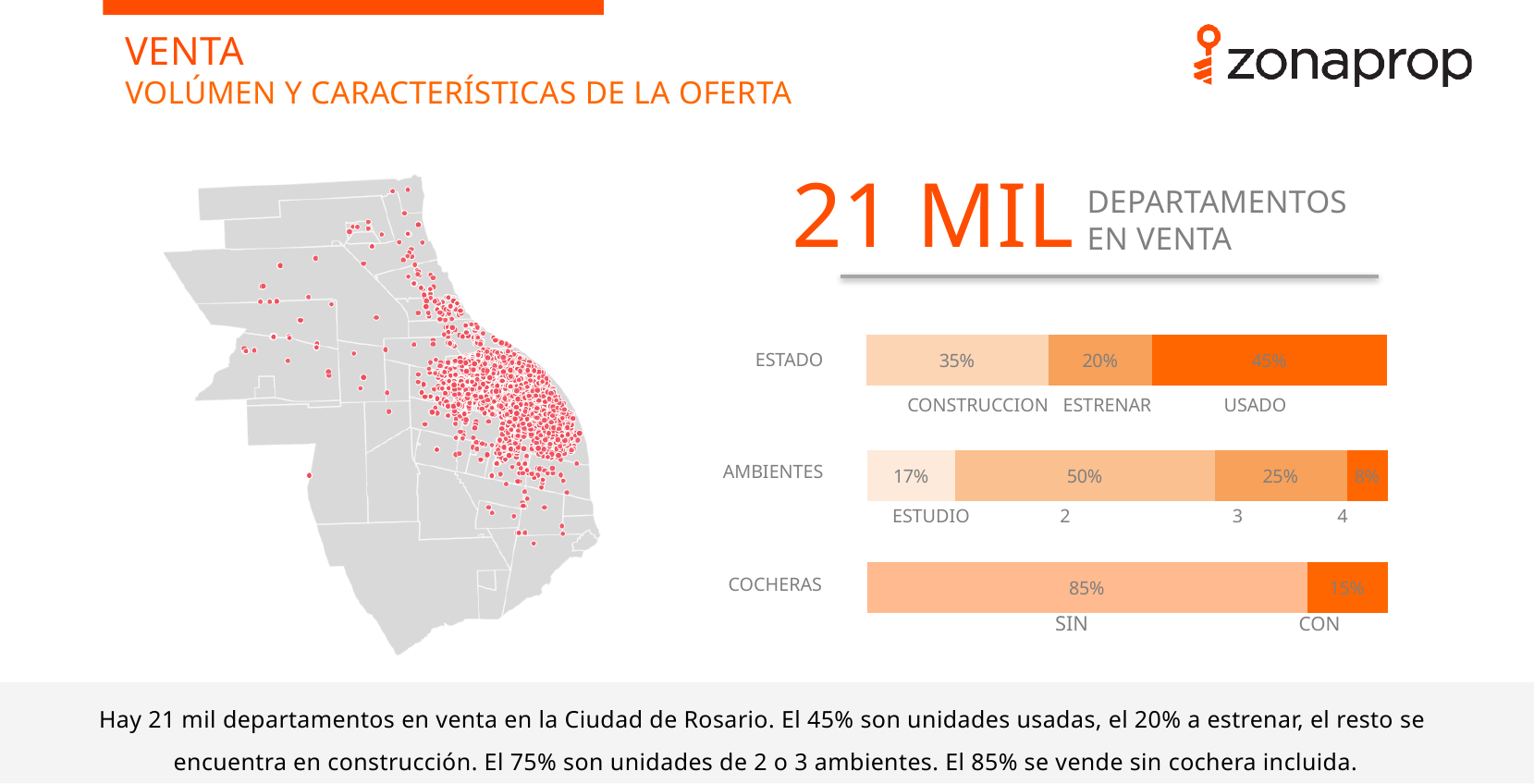
In the AMBIENTES bar, which category has the smallest share? 4 In the AMBIENTES bar, what percentage are ESTUDIO? 17% What is the combined percentage of apartments with 2 or 3 ambientes in the AMBIENTES bar? 75% In the ESTADO bar, what percentage is in CONSTRUCCION? 35% How many segments does the AMBIENTES bar have? 4 In the AMBIENTES bar, what percentage of apartments have 2 ambientes? 50% What is the difference in percentage points between SIN and CON in the COCHERAS bar? 70 In the COCHERAS bar, what percentage of apartments are sold CON cochera? 15% In the ESTADO bar, which category has the largest share? USADO What type of chart is used to show ESTADO, AMBIENTES and COCHERAS? Stacked bar chart In the ESTADO bar, what percentage of apartments for sale are USADO? 45% In the ESTADO bar, which is larger: CONSTRUCCION or ESTRENAR? CONSTRUCCION